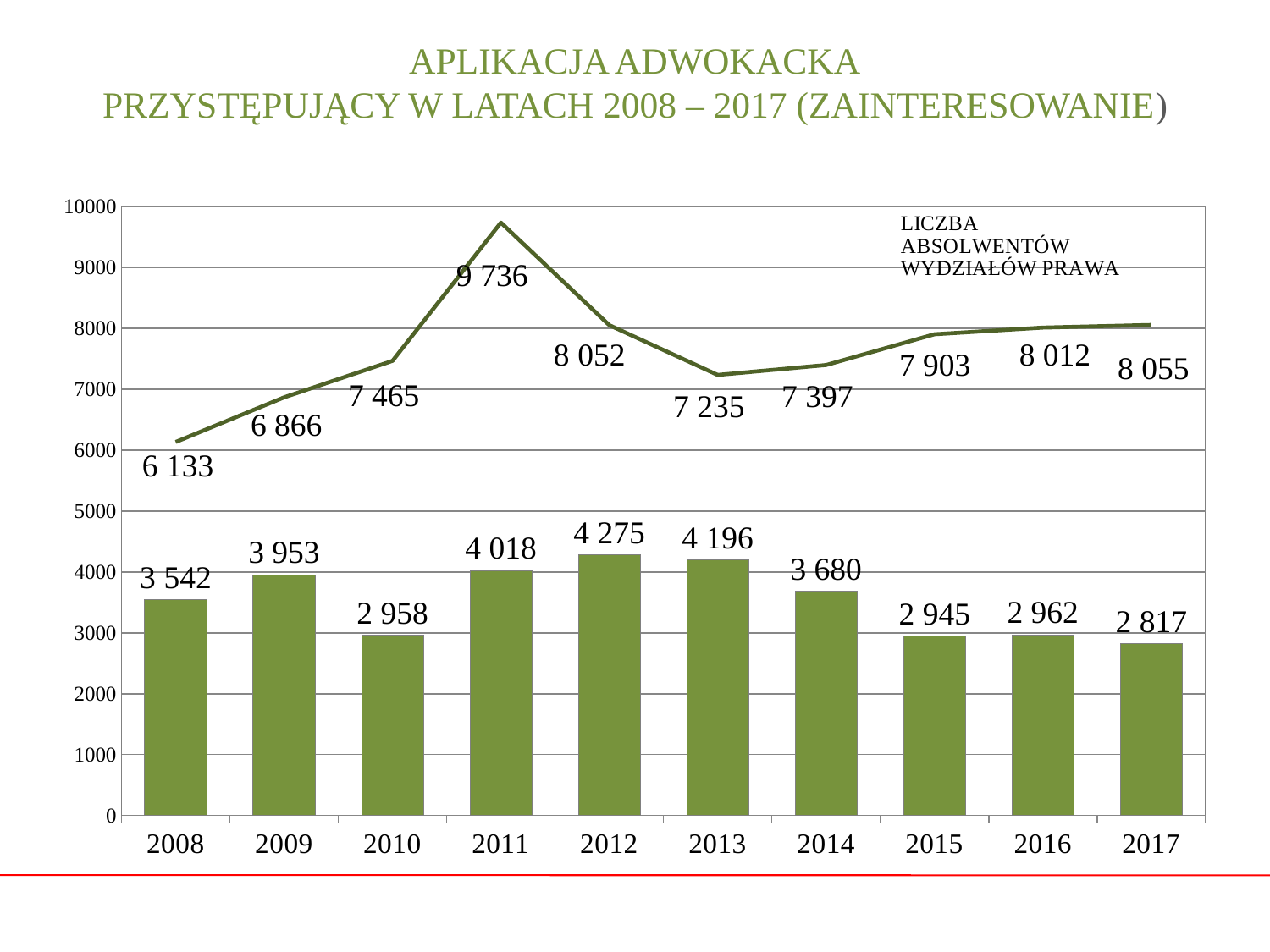
Which is larger, the bar value for 2009 or the bar value for 2014? 2009 What is the difference between the bar values for 2012 and 2017? 1 458 How many years are shown on the x axis? 10 Which year has the highest bar value? 2012 What value does the line (LICZBA ABSOLWENTÓW WYDZIAŁÓW PRAWA) show for 2008? 6 133 What is the value of the bar for 2012? 4 275 What is the value of the bar for 2017? 2 817 What kinds of chart are combined on this slide? A bar chart and a line chart What value does the line (LICZBA ABSOLWENTÓW WYDZIAŁÓW PRAWA) show for 2011? 9 736 Do the bar values rise or fall from 2014 to 2015? fall In which year does the line (LICZBA ABSOLWENTÓW WYDZIAŁÓW PRAWA) reach its highest value? 2011 Which year has the lowest bar value? 2017